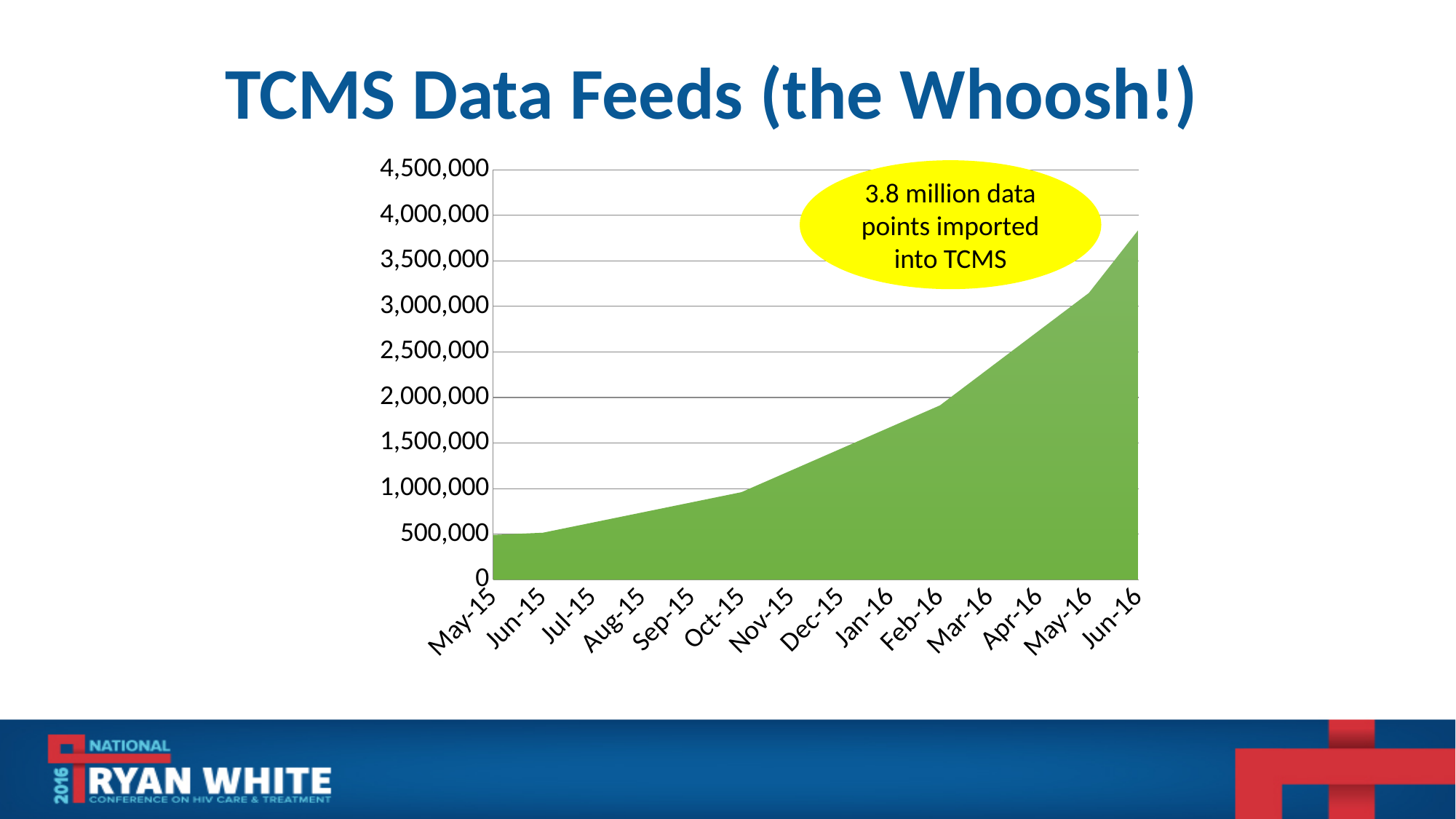
What is the title of the slide containing the chart? TCMS Data Feeds (the Whoosh!) Is the value for Sep-15 greater or less than 1,000,000? less Which is larger, the value for Apr-16 or the value for Dec-15? Apr-16 Do the values rise or fall from May-15 to Jun-16? Rise What kind of chart is shown on the slide? Area chart Is the value for Jun-16 greater or less than 3,500,000? greater Is the value for Apr-16 greater or less than 2,500,000? greater How many months are plotted along the x axis of the chart? 14 According to the callout on the chart, how many data points were imported into TCMS? 3.8 million Which month has the highest value in the chart? Jun-16